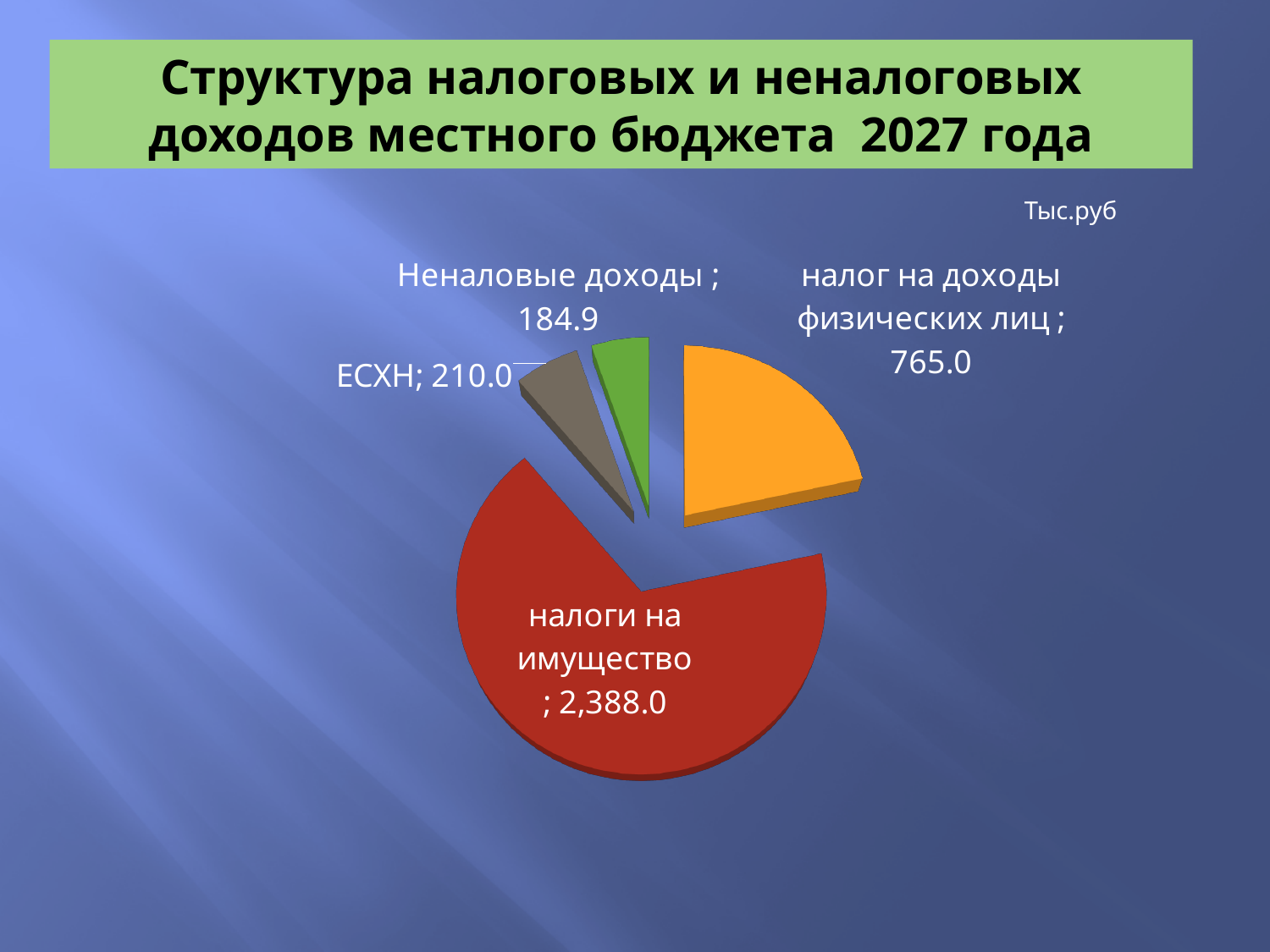
What kind of chart is shown on the slide? pie chart What unit is indicated for the values on the slide? Тыс.руб What is the value for налог на доходы физических лиц? 765.0 How many slices does the pie chart have? 4 Which category has the largest slice of the pie? налоги на имущество What is the value for ЕСХН? 210.0 What is the value for Неналовые доходы? 184.9 Which is larger, ЕСХН or налог на доходы физических лиц? налог на доходы физических лиц What is the difference between ЕСХН and Неналовые доходы? 25.1 Which category has the smallest slice of the pie? Неналовые доходы What is the difference between налоги на имущество and налог на доходы физических лиц? 1,623.0 What is the value for налоги на имущество? 2,388.0